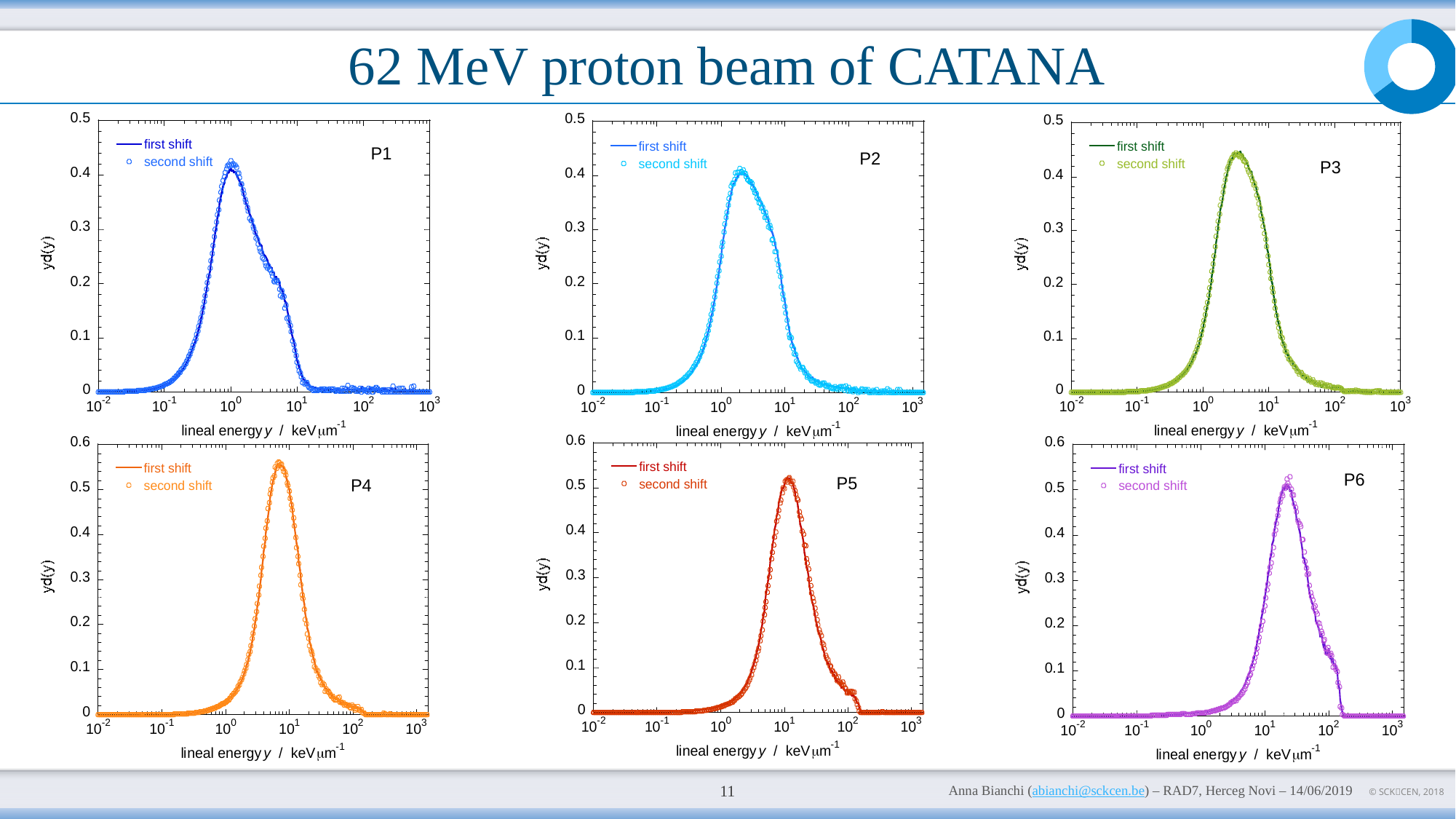
Which chart has the higher peak value of yd(y), P2 or P5? P5 What kind of chart is the P3 chart? line chart In the P1 chart, how many series does the legend list? 2 What is the x-axis label of the P2 chart? lineal energy y / keV μm-1 Which chart has the higher peak value of yd(y), P1 or P4? P4 In the P6 chart, is the peak value of yd(y) greater or less than 0.4? greater How many charts are shown on the slide? 6 What are the two legend entries in the P4 chart? first shift, second shift In the P4 chart, is the peak value of yd(y) greater or less than 0.5? greater In the P1 chart, is the peak value of yd(y) greater or less than 0.4? greater